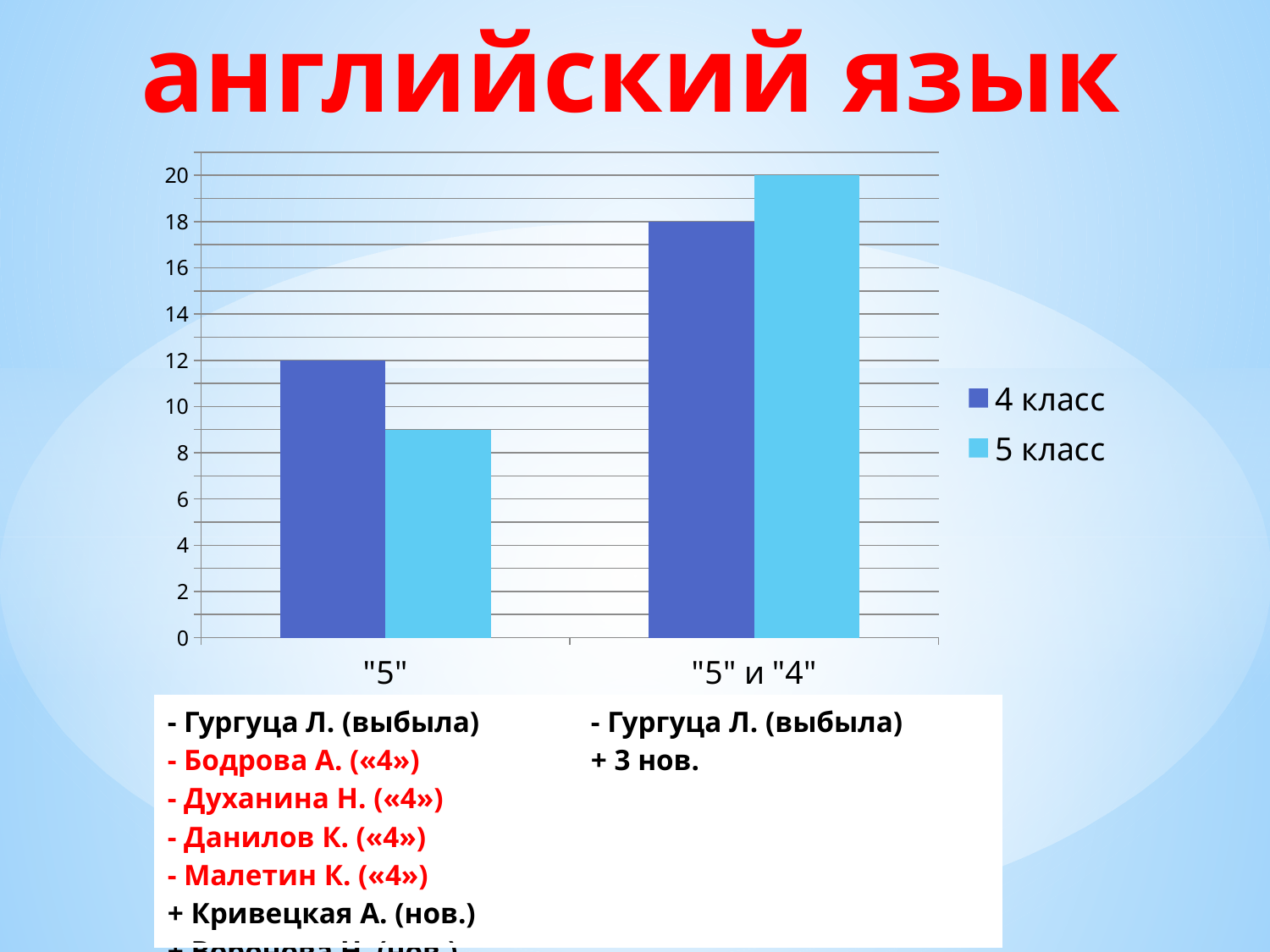
What is the value for 5 класс in the "5" и "4" category? 20 How many categories are shown on the x axis? 2 What is the difference between the 4 класс values for "5" и "4" and "5"? 6 What is the value for 4 класс in the "5" category? 12 Is the value for 5 класс in the "5" category greater or less than 8? greater How many series does the legend list? 2 What type of chart is shown on the slide? bar chart Is the value for 5 класс in the "5" category greater or less than 10? less In the "5" category, which series has the larger value, 4 класс or 5 класс? 4 класс What is the title of the slide above the chart? английский язык What is the value for 4 класс in the "5" и "4" category? 18 Which category has the highest value for 5 класс? "5" и "4"